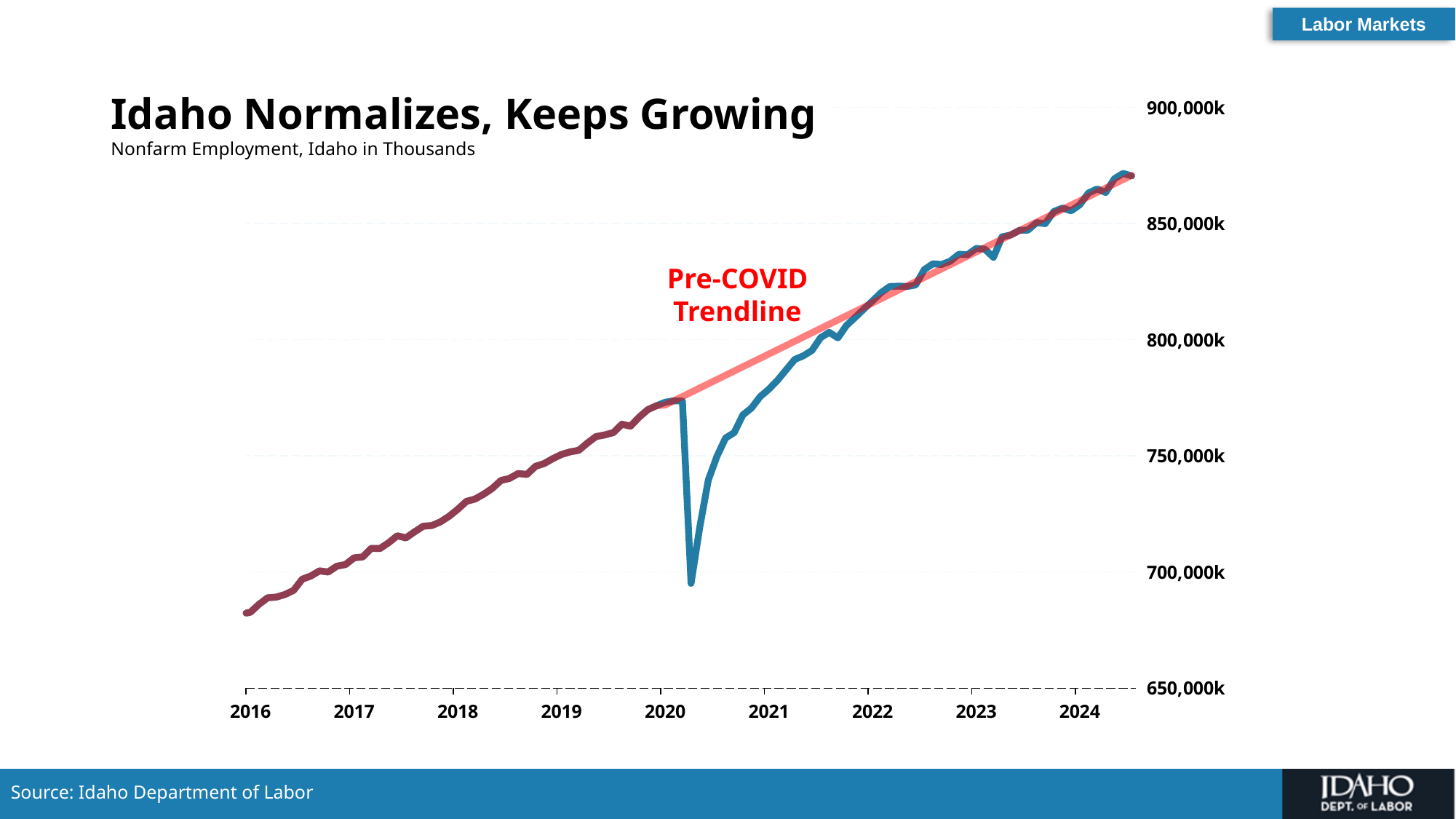
What kind of chart is shown on the slide? Line chart Is the nonfarm employment value at the start of 2022 greater or less than 800,000k? greater How many year labels are shown on the x axis? 9 What is the title of the chart? Idaho Normalizes, Keeps Growing What does the red annotation on the chart label? Pre-COVID Trendline Is the nonfarm employment value at the end of the series in 2024 greater or less than 850,000k? greater Is the nonfarm employment value at the start of 2020 greater or less than 750,000k? greater Overall, do the nonfarm employment values rise or fall from 2016 to 2024? Rise Which is larger, the nonfarm employment value at the start of 2016 or at the end of 2024? End of 2024